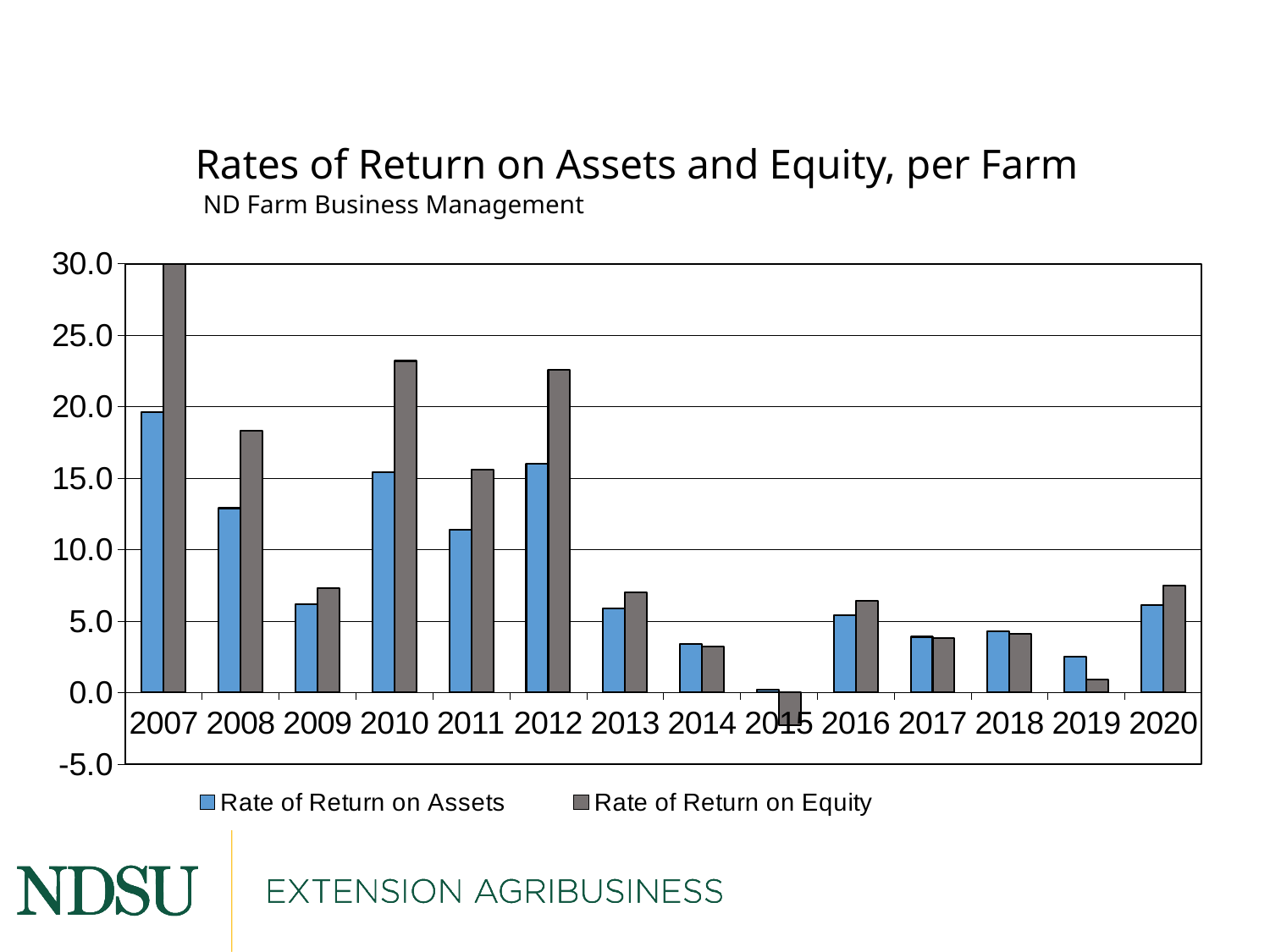
What kind of chart is shown on the slide? bar chart Is the Rate of Return on Assets for 2019 greater or less than 5.0? less In 2010, which is larger: the Rate of Return on Assets or the Rate of Return on Equity? Rate of Return on Equity How many years are shown on the x axis? 14 How many series does the legend list? 2 Does the Rate of Return on Assets rise or fall from 2012 to 2015? fall What is the subtitle shown under the chart title? ND Farm Business Management Which year has the lowest Rate of Return on Equity? 2015 Is the Rate of Return on Assets for 2007 greater or less than 15.0? greater In 2019, which is larger: the Rate of Return on Assets or the Rate of Return on Equity? Rate of Return on Assets Which year has the highest Rate of Return on Assets? 2007 Is the Rate of Return on Equity for 2010 greater or less than 20.0? greater